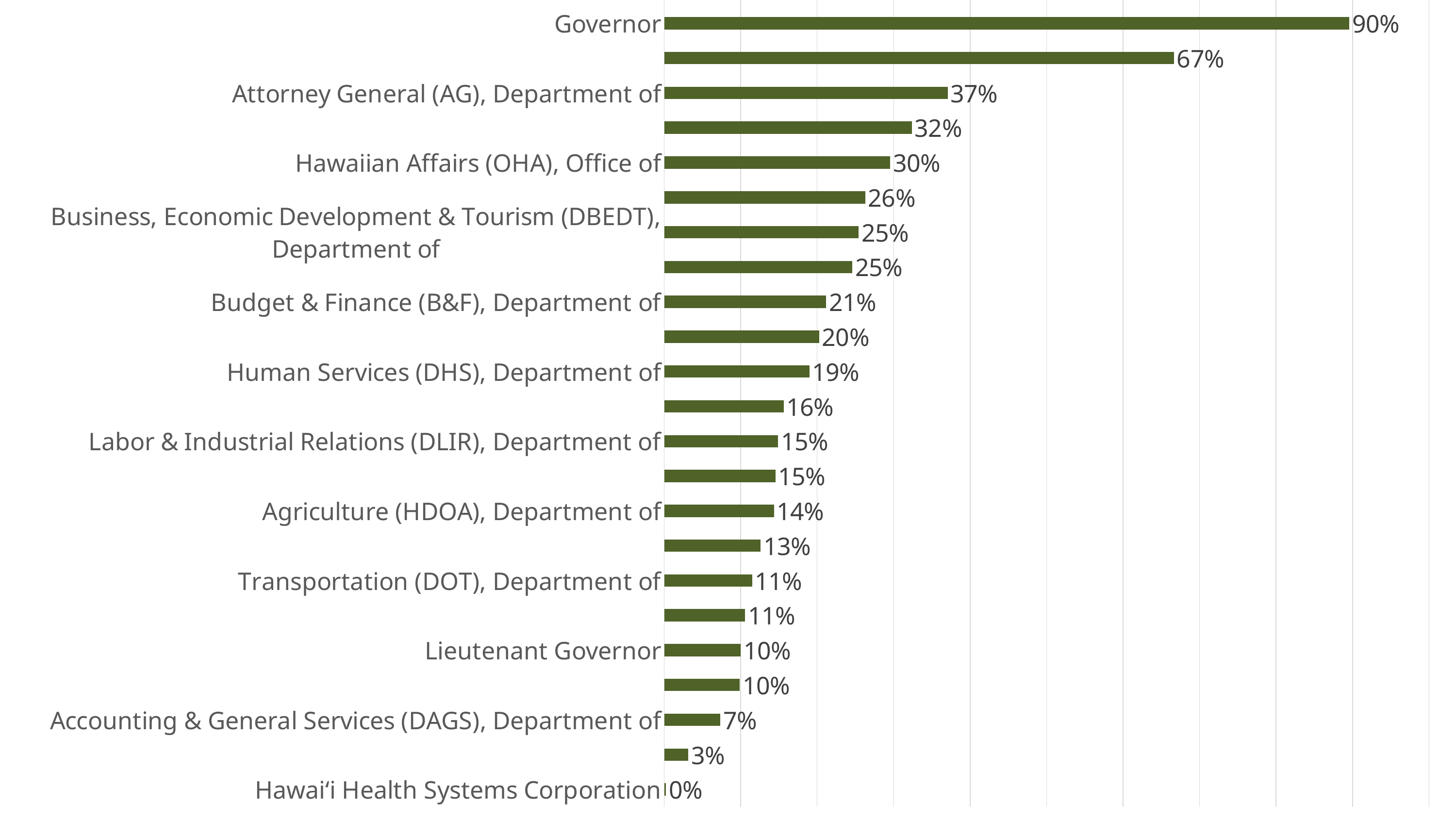
What is the value for Governor? 90% What kind of chart is shown on the slide? Bar chart How many bars are plotted in the chart? 23 Which is larger, the value for Human Services (DHS), Department of or the value for Transportation (DOT), Department of? Human Services (DHS), Department of What is the difference between the values for Governor and Attorney General (AG), Department of? 53% What is the value for Attorney General (AG), Department of? 37% Which category has the lowest value? Hawaiʻi Health Systems Corporation What is the value for Budget & Finance (B&F), Department of? 21% What is the value for Hawaiian Affairs (OHA), Office of? 30% Which category has the highest value? Governor What is the value for Hawaiʻi Health Systems Corporation? 0% What is the value for Lieutenant Governor? 10%